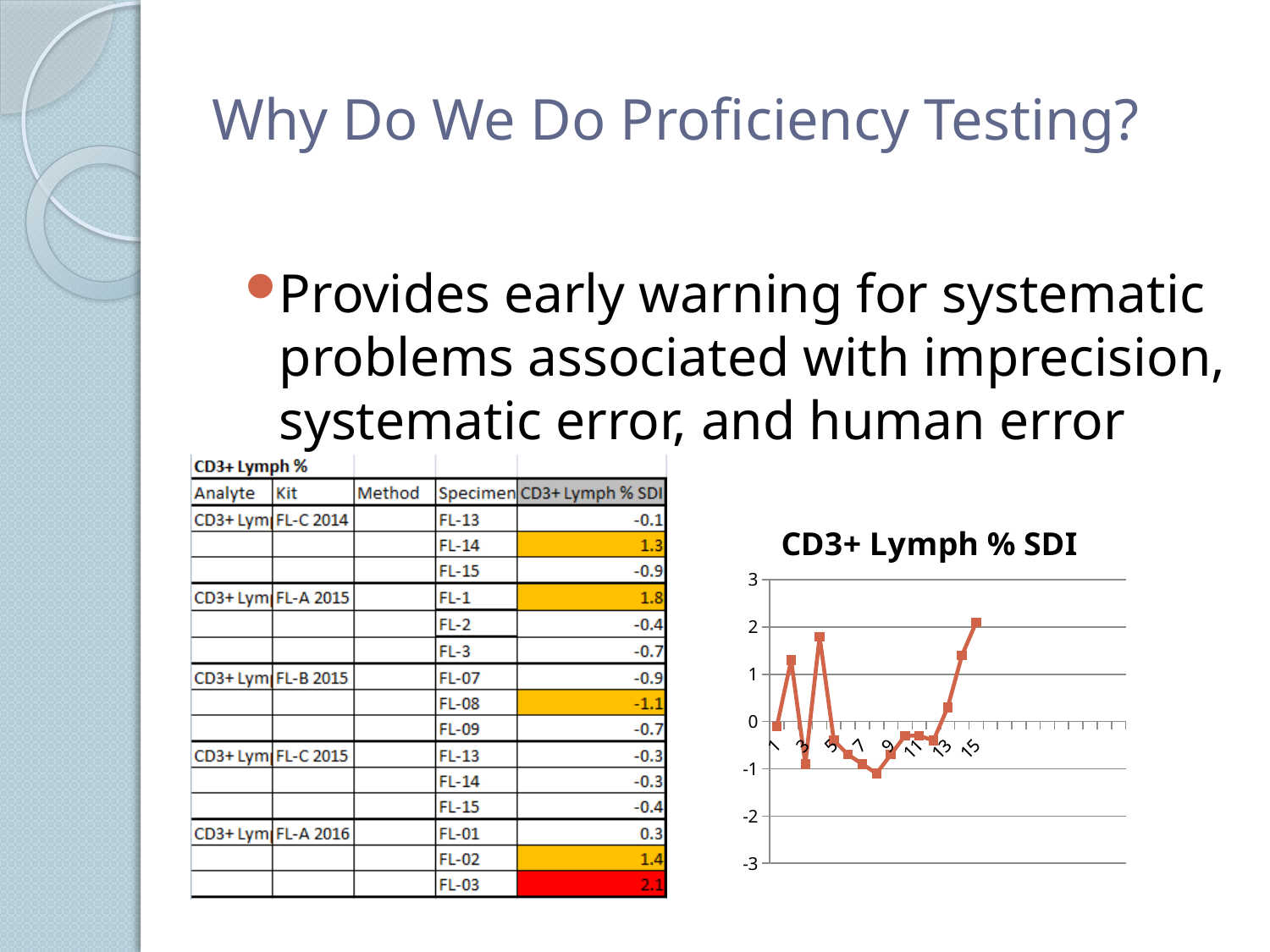
What are the minimum and maximum values shown on the y-axis of the CD3+ Lymph % SDI chart? -3 and 3 What is the title of the chart on the slide? CD3+ Lymph % SDI On the CD3+ Lymph % SDI chart, which has the larger value, point 2 or point 4? point 4 On the CD3+ Lymph % SDI chart, is the value at point 4 greater or less than 2? less On the CD3+ Lymph % SDI chart, is the value at point 3 greater or less than 0? less What kind of chart is the CD3+ Lymph % SDI chart? line chart On the CD3+ Lymph % SDI chart, do the values rise or fall from point 11 to point 15? rise On the CD3+ Lymph % SDI chart, which has the larger value, point 4 or point 15? point 15 On the CD3+ Lymph % SDI chart, which point number has the highest value? 15 On the CD3+ Lymph % SDI chart, is the value at point 2 greater or less than 1? greater How many data points are plotted on the CD3+ Lymph % SDI chart? 15